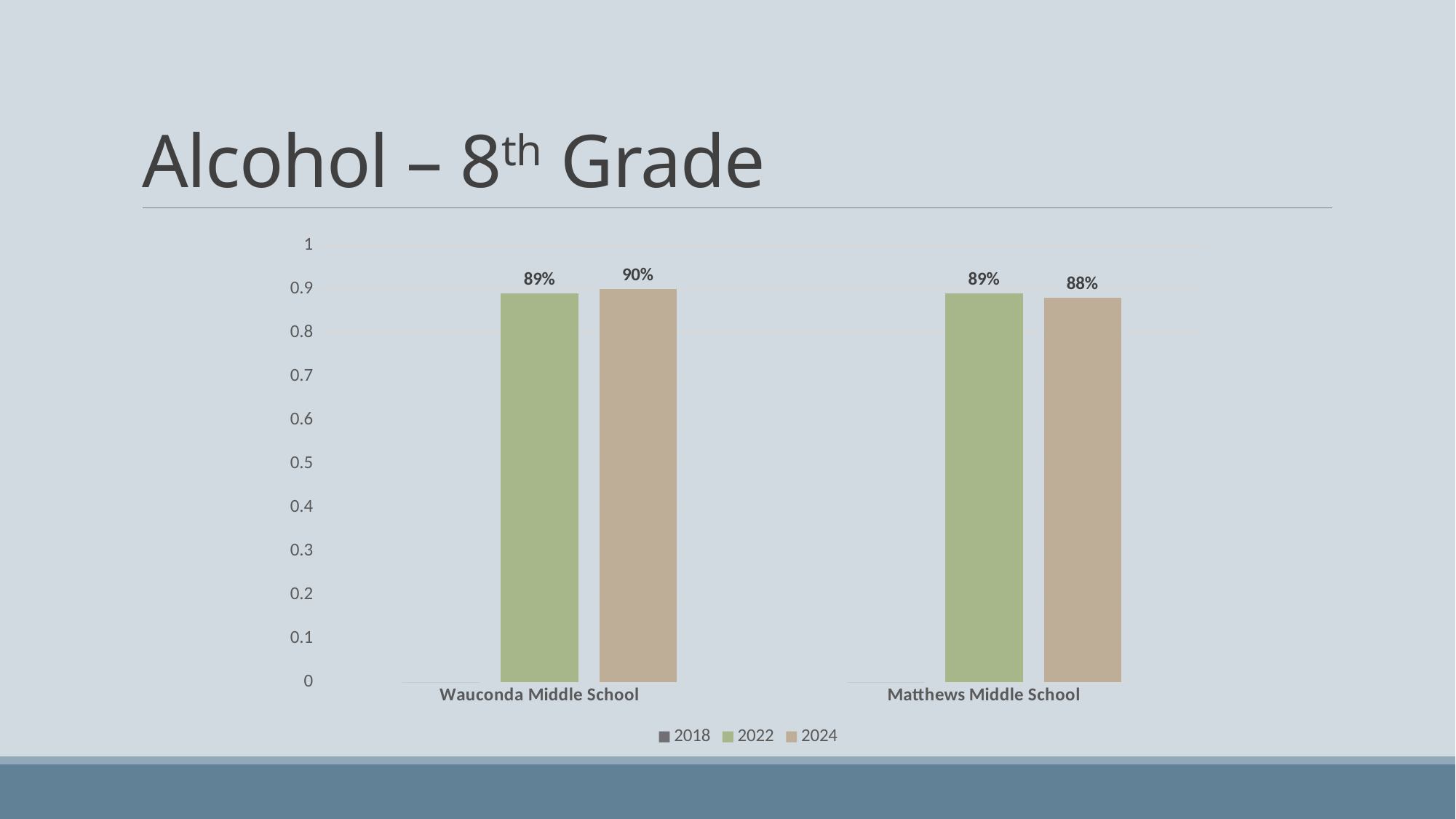
What is the 2022 value for Wauconda Middle School? 89% How many series does the legend list? 3 Which school has the higher 2024 value? Wauconda Middle School What kind of chart is shown on the slide? bar chart What is the difference between the 2024 values for Wauconda Middle School and Matthews Middle School? 2% What is the 2024 value for Wauconda Middle School? 90% What is the title of the slide? Alcohol – 8th Grade What is the 2022 value for Matthews Middle School? 89% What is the difference between the 2022 and 2024 values for Matthews Middle School? 1% What is the 2024 value for Matthews Middle School? 88% How many schools are shown on the x axis? 2 Is the 2024 value for Matthews Middle School greater or less than 0.9? less